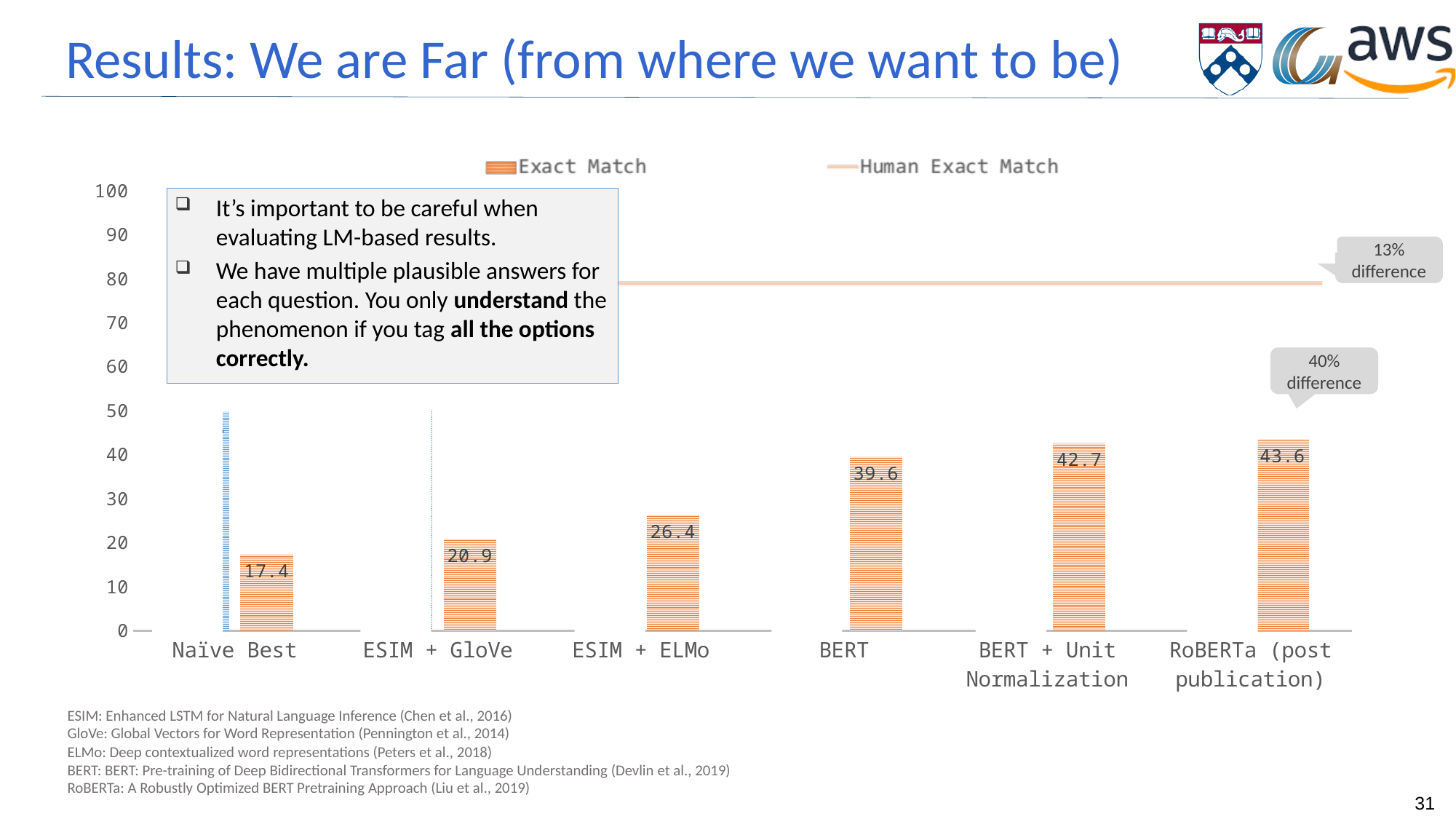
Which has a higher Exact Match value, ESIM + ELMo or BERT? BERT What kind of chart is used to show the Exact Match values? bar chart Is the Human Exact Match line greater or less than 70? greater Which category has the highest Exact Match value? RoBERTa (post publication) What is the difference between the Exact Match values for BERT + Unit Normalization and ESIM + GloVe? 21.8 Which category has the lowest Exact Match value? Naïve Best How many series does the legend list? 2 What is the Exact Match value for Naïve Best? 17.4 What is the Exact Match value for BERT? 39.6 What is the Exact Match value for RoBERTa (post publication)? 43.6 Do the Exact Match values rise or fall from Naïve Best to RoBERTa (post publication)? rise How many categories are shown on the x axis? 6